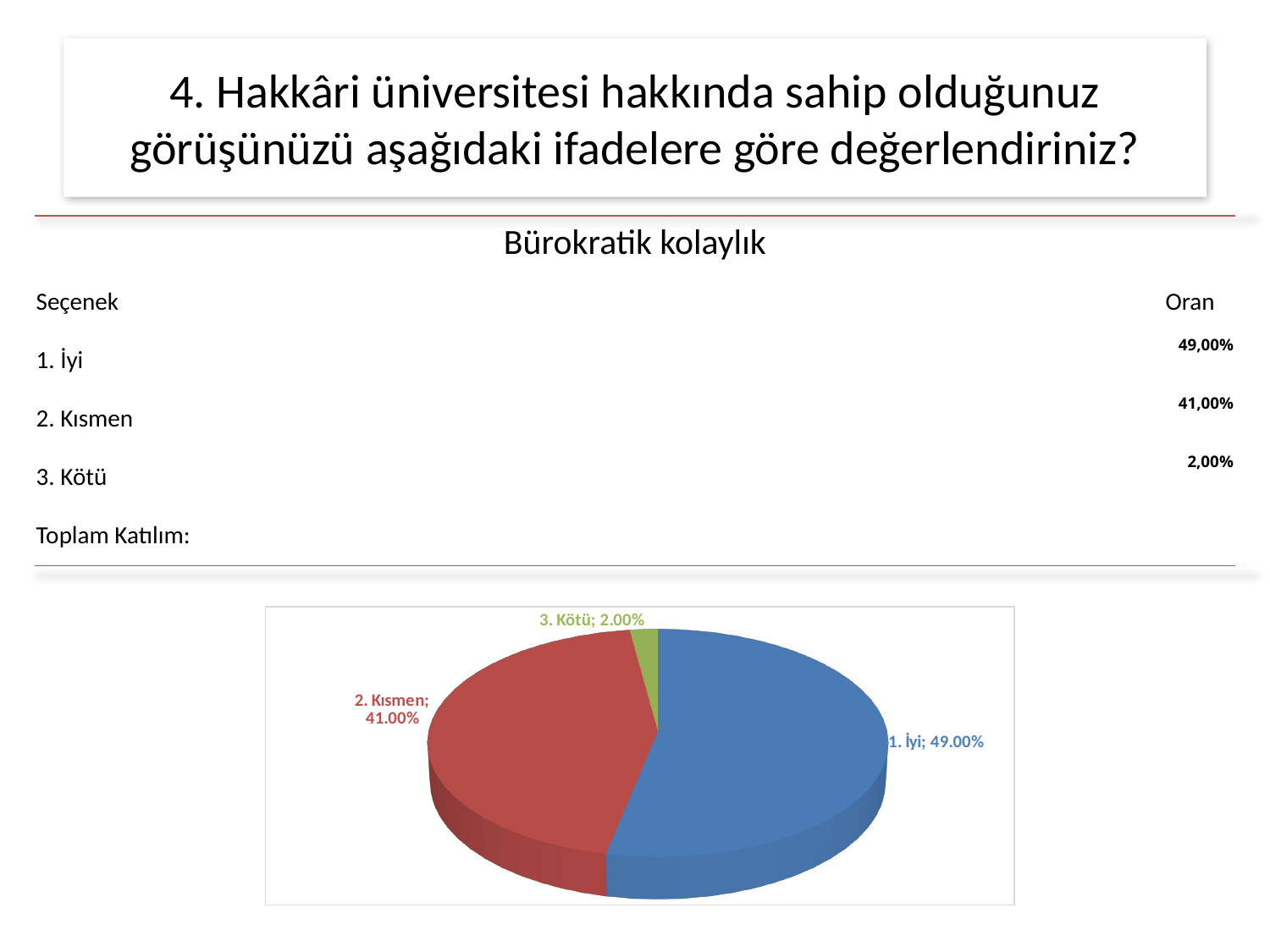
Which is larger, the slice for 2. Kısmen or the slice for 3. Kötü? 2. Kısmen What is the difference between the values for 2. Kısmen and 3. Kötü? 39.00% How many slices does the pie chart have? 3 What colour is the slice for 2. Kısmen? red What is the value shown for the slice labelled 1. İyi? 49.00% Which slice of the pie chart is the largest? 1. İyi What is the value shown for the slice labelled 3. Kötü? 2.00% What is the value shown for the slice labelled 2. Kısmen? 41.00% What colour is the slice for 1. İyi? blue What is the difference between the values for 1. İyi and 2. Kısmen? 8.00% What kind of chart is shown on the slide? pie chart Which slice of the pie chart is the smallest? 3. Kötü